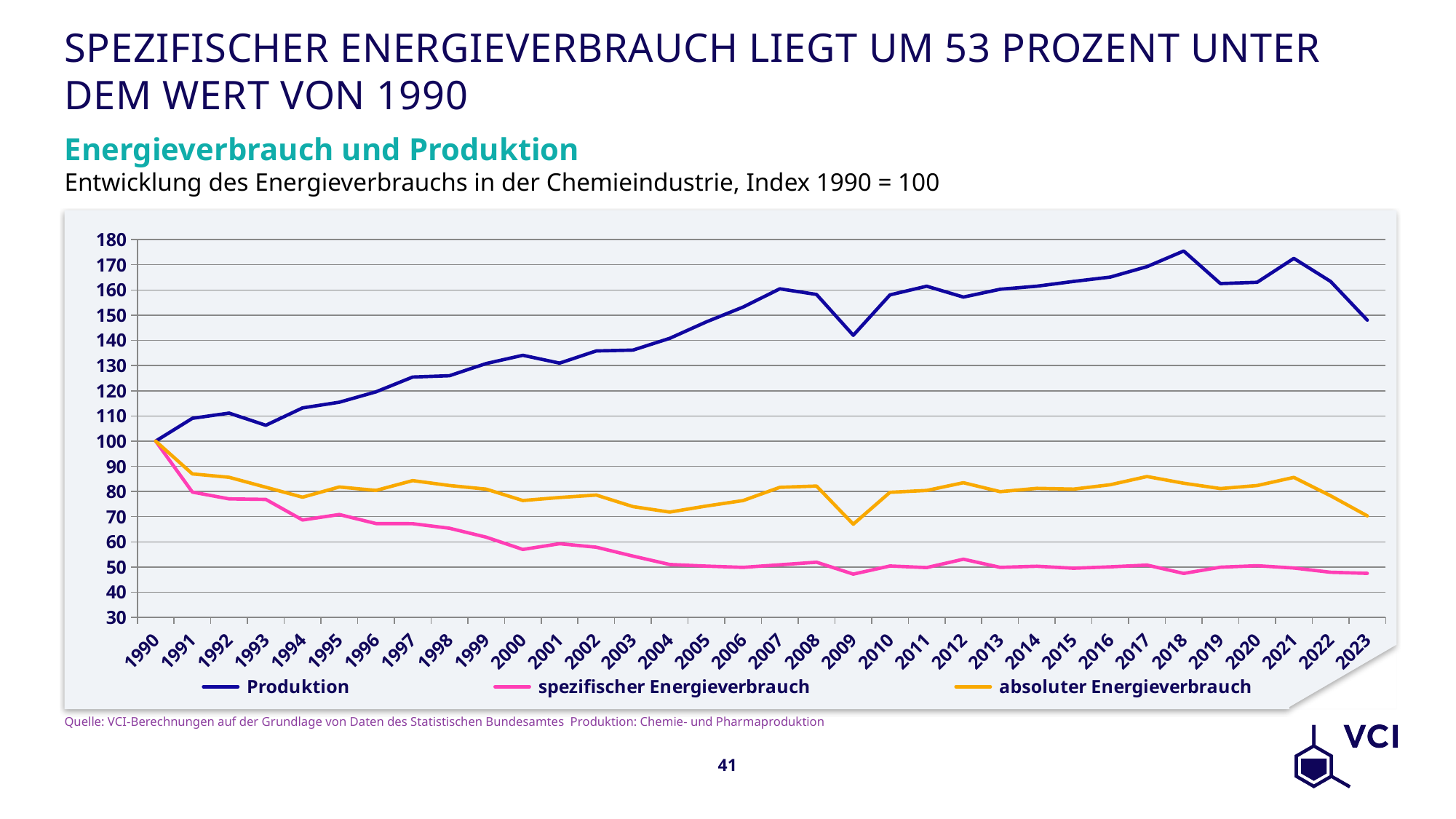
Is the value for Produktion in 2018 greater or less than 170? greater In which year does Produktion reach its highest value? 2018 In which year is spezifischer Energieverbrauch at its highest? 1990 Is the value for Produktion in 2009 greater or less than 150? less How many series does the legend list? 3 What is the value of Produktion in 1990? 100 Does spezifischer Energieverbrauch rise or fall overall from 1990 to 2023? fall How many years are plotted along the x axis? 34 Is the value for absoluter Energieverbrauch in 2017 greater or less than 80? greater What kind of chart is shown on the slide? line chart Which is larger in 2023: absoluter Energieverbrauch or spezifischer Energieverbrauch? absoluter Energieverbrauch